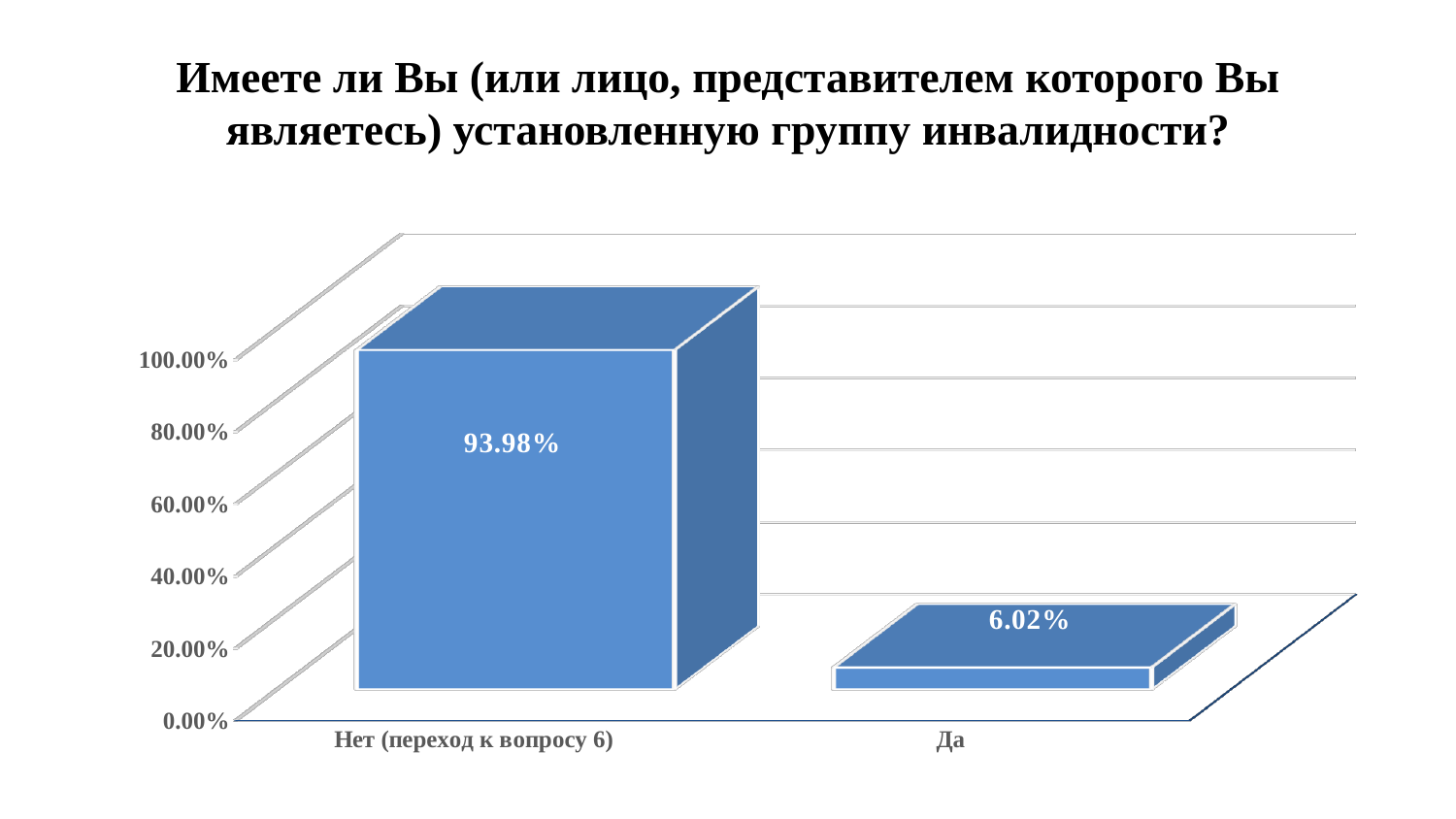
Is the value for "Нет (переход к вопросу 6)" greater or less than 80.00%? greater What is the value for "Да"? 6.02% Which category has the highest value? Нет (переход к вопросу 6) Which is larger, the value for "Да" or the value for "Нет (переход к вопросу 6)"? Нет (переход к вопросу 6) How many categories are shown on the x axis? 2 Is the value for "Да" greater or less than 20.00%? less What is the title of the chart? Имеете ли Вы (или лицо, представителем которого Вы являетесь) установленную группу инвалидности? What is the value for "Нет (переход к вопросу 6)"? 93.98% What is the total of the two values shown in the chart? 100.00% What is the difference between the values for "Нет (переход к вопросу 6)" and "Да"? 87.96% Which category has the lowest value? Да What kind of chart is shown on the slide? bar chart